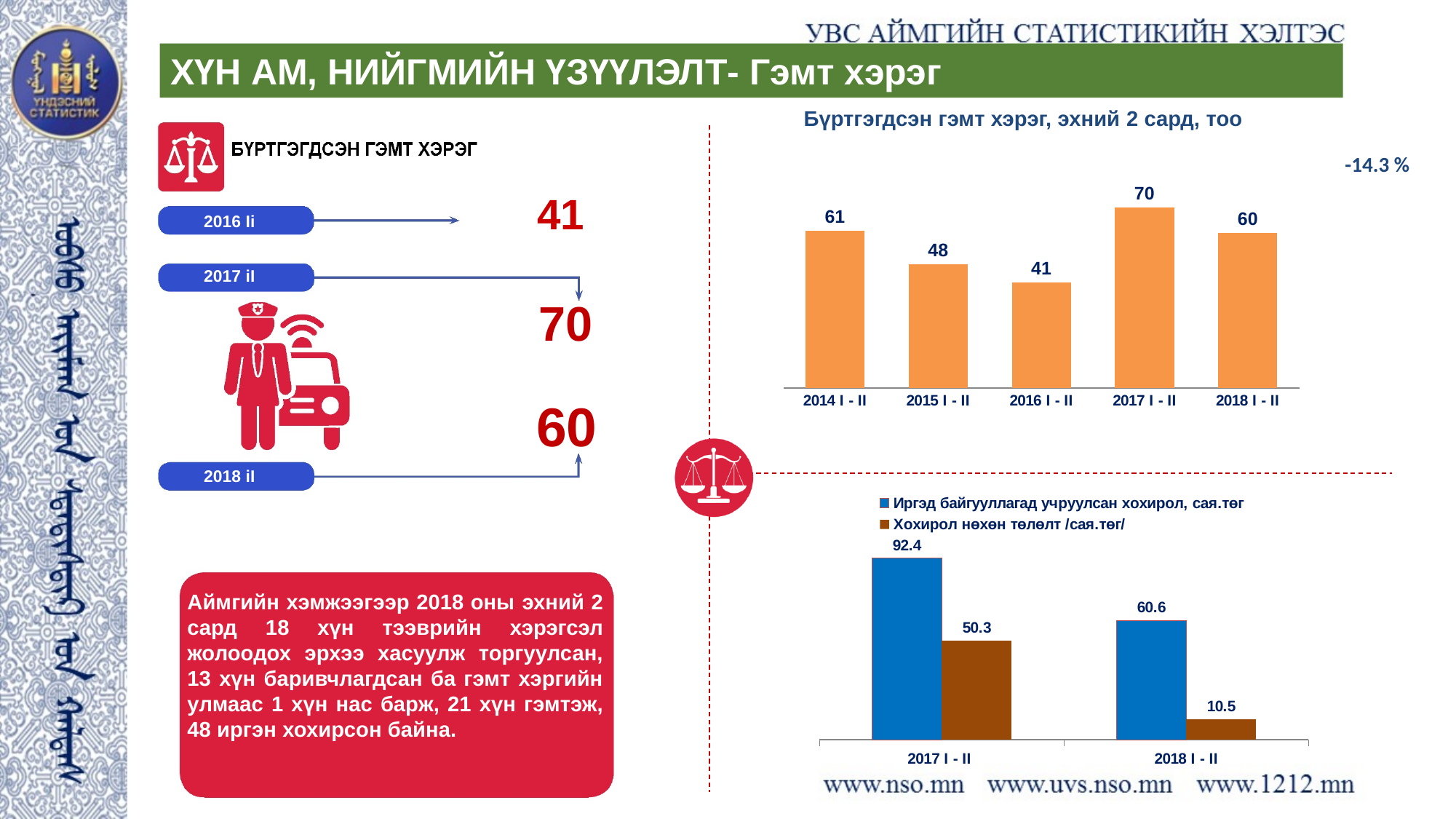
In the bottom chart, does 'Хохирол нөхөн төлөлт /сая.төг/' rise or fall from 2017 I - II to 2018 I - II? Fall How many periods are shown on the x axis of the top chart 'Бүртгэгдсэн гэмт хэрэг, эхний 2 сард, тоо'? 5 What kind of chart is the top chart 'Бүртгэгдсэн гэмт хэрэг, эхний 2 сард, тоо'? Bar chart In the bottom chart, what is the difference between 'Иргэд байгууллагад учруулсан хохирол, сая.төг' for 2017 I - II and 2018 I - II? 31.8 In the bottom chart, what is the value of 'Хохирол нөхөн төлөлт /сая.төг/' for 2018 I - II? 10.5 In the top chart 'Бүртгэгдсэн гэмт хэрэг, эхний 2 сард, тоо', which period has the lowest value? 2016 I - II In the top chart 'Бүртгэгдсэн гэмт хэрэг, эхний 2 сард, тоо', what is the value for 2016 I - II? 41 How many series does the legend of the bottom chart list? 2 In the bottom chart, what is the value of 'Иргэд байгууллагад учруулсан хохирол, сая.төг' for 2017 I - II? 92.4 In the top chart 'Бүртгэгдсэн гэмт хэрэг, эхний 2 сард, тоо', which is larger: the value for 2014 I - II or 2015 I - II? 2014 I - II In the top chart 'Бүртгэгдсэн гэмт хэрэг, эхний 2 сард, тоо', which period has the highest value? 2017 I - II In the top chart 'Бүртгэгдсэн гэмт хэрэг, эхний 2 сард, тоо', what is the difference between the values for 2017 I - II and 2018 I - II? 10